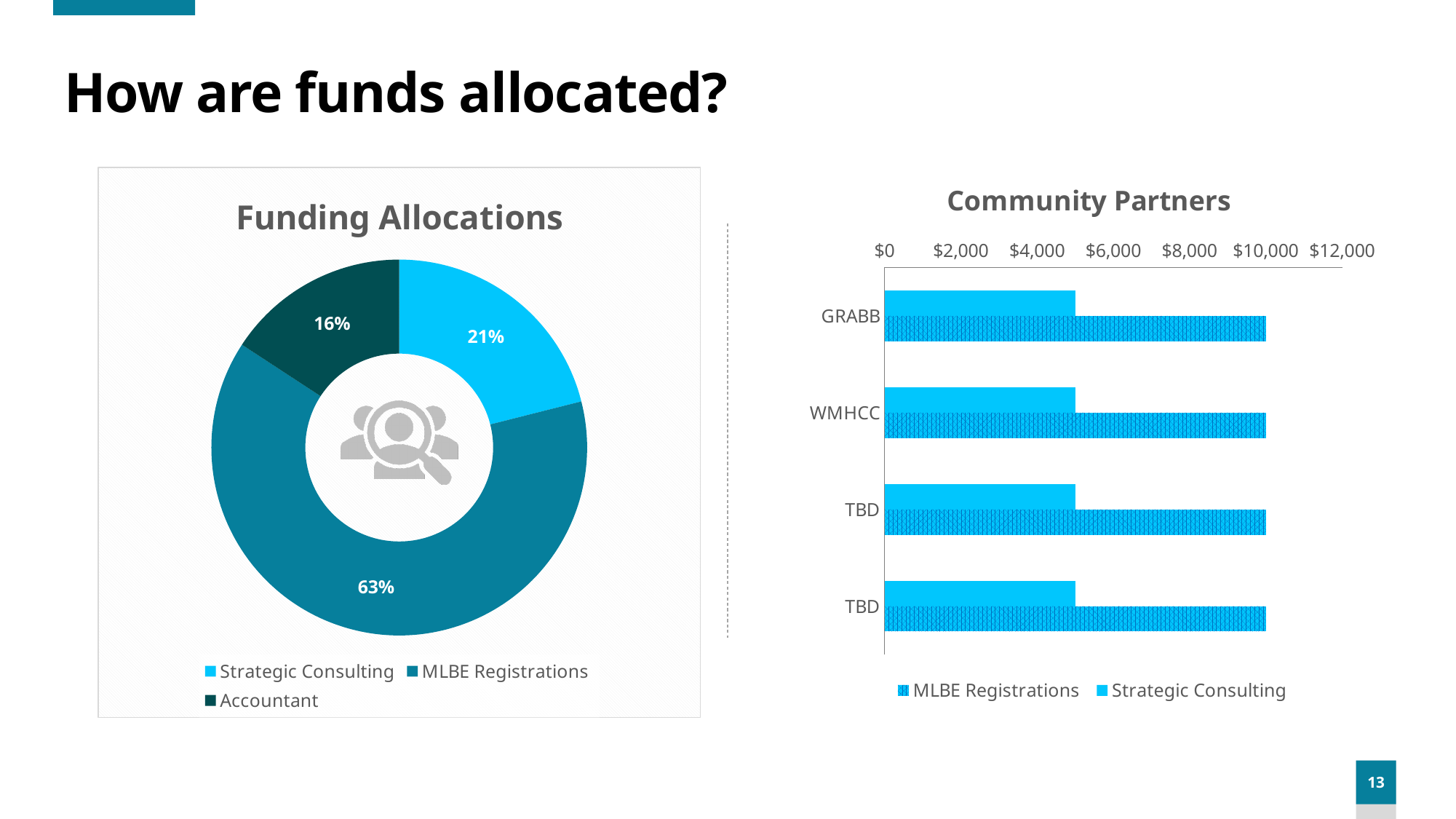
In the Funding Allocations chart, which category has the largest share? MLBE Registrations In the Community Partners chart, is the Strategic Consulting value for GRABB greater or less than $6,000? less How many series does the legend of the Community Partners chart list? 2 In the Funding Allocations chart, which category has the smallest share? Accountant In the Funding Allocations chart, what is the difference in percentage points between MLBE Registrations and Strategic Consulting? 42 In the Funding Allocations chart, what share is allocated to Accountant? 16% What kind of chart is the Funding Allocations chart? Pie (donut) chart In the Funding Allocations chart, what share is allocated to Strategic Consulting? 21% In the Community Partners chart, for WMHCC, which series has the larger value, MLBE Registrations or Strategic Consulting? MLBE Registrations In the Funding Allocations chart, what share is allocated to MLBE Registrations? 63% How many categories are shown on the Community Partners chart? 4 What kind of chart is the Community Partners chart? Bar chart